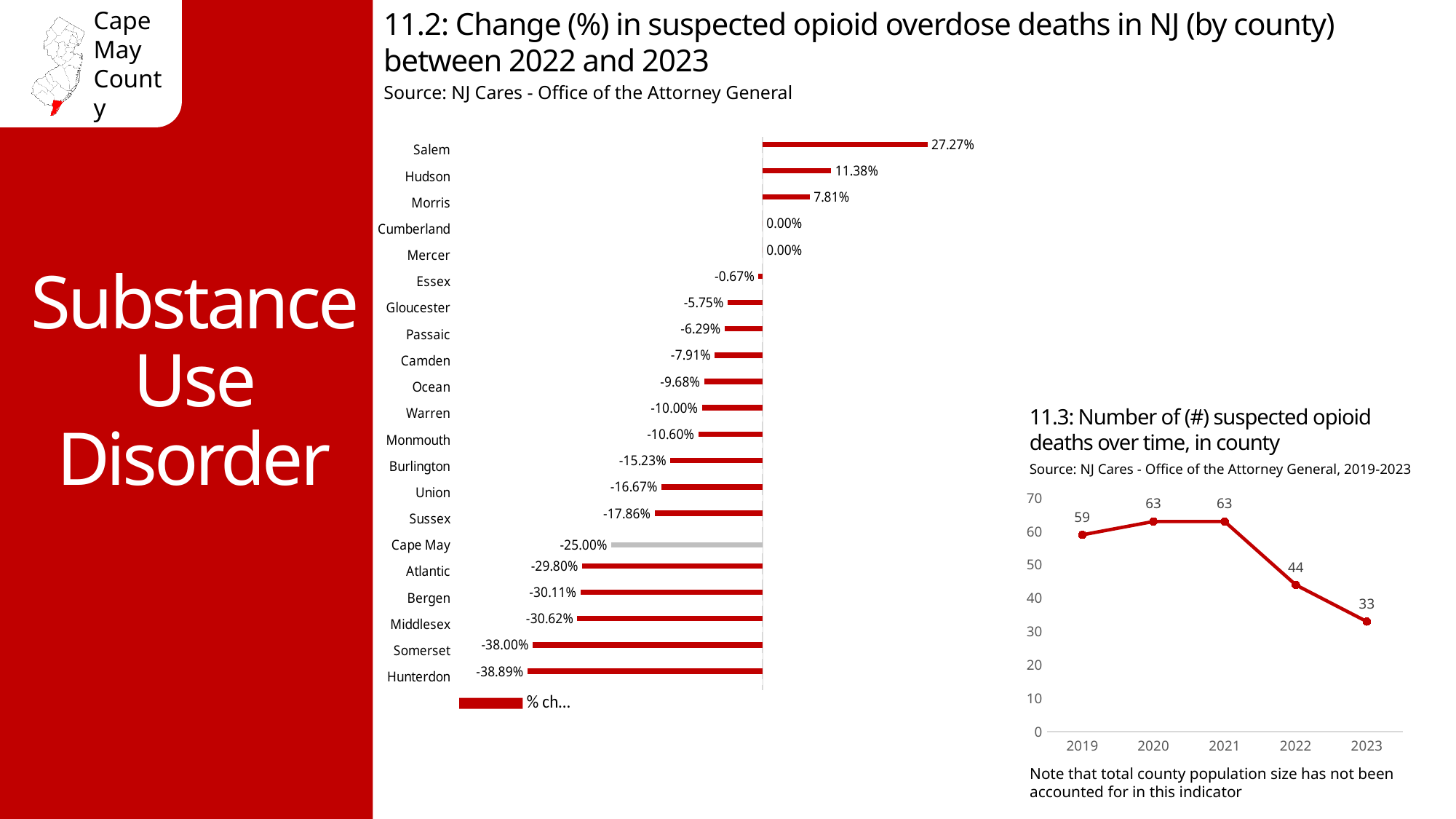
In the chart '11.3: Number of (#) suspected opioid deaths over time, in county', do the values rise or fall from 2021 to 2023? Fall In the chart '11.2: Change (%) in suspected opioid overdose deaths in NJ (by county) between 2022 and 2023', what is the value for Cape May? -25.00% In the chart '11.3: Number of (#) suspected opioid deaths over time, in county', what is the difference between the 2021 value and the 2022 value? 19 In the chart '11.3: Number of (#) suspected opioid deaths over time, in county', what is the value for 2023? 33 In the chart '11.2: Change (%) in suspected opioid overdose deaths in NJ (by county) between 2022 and 2023', what kind of chart is it? Bar chart In the chart '11.2: Change (%) in suspected opioid overdose deaths in NJ (by county) between 2022 and 2023', which county has the lowest value? Hunterdon In the chart '11.2: Change (%) in suspected opioid overdose deaths in NJ (by county) between 2022 and 2023', how many counties are shown? 21 In the chart '11.3: Number of (#) suspected opioid deaths over time, in county', how many years are plotted? 5 In the chart '11.3: Number of (#) suspected opioid deaths over time, in county', what kind of chart is it? Line chart In the chart '11.2: Change (%) in suspected opioid overdose deaths in NJ (by county) between 2022 and 2023', what is the value for Hudson? 11.38% In the chart '11.2: Change (%) in suspected opioid overdose deaths in NJ (by county) between 2022 and 2023', which county has the highest value? Salem In the chart '11.2: Change (%) in suspected opioid overdose deaths in NJ (by county) between 2022 and 2023', which is larger, the value for Bergen or the value for Atlantic? Atlantic